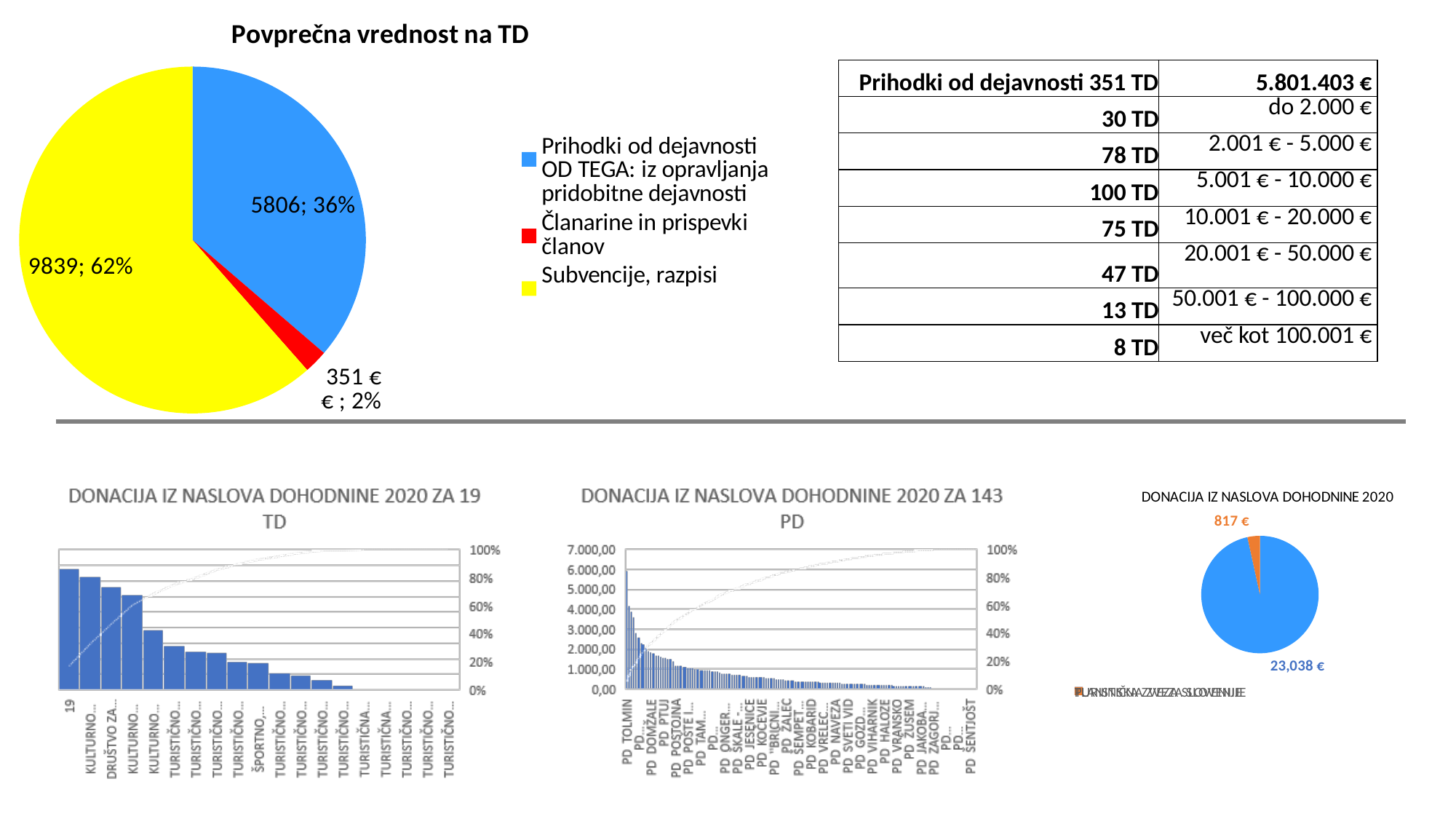
In the pie chart at the bottom right titled 'DONACIJA IZ NASLOVA DOHODNINE 2020', which of the two labelled values is larger, 817 € or 23,038 €? 23,038 € In the pie chart titled 'Povprečna vrednost na TD', what value and share are shown for 'Subvencije, razpisi'? 9839; 62% In the pie chart titled 'Povprečna vrednost na TD', what colour is the slice for 'Subvencije, razpisi'? Yellow In the chart titled 'DONACIJA IZ NASLOVA DOHODNINE 2020 ZA 19 TD', do the bar values rise or fall from left to right? Fall In the pie chart titled 'Povprečna vrednost na TD', which category has the smallest slice? Članarine in prispevki članov In the pie chart at the bottom right titled 'DONACIJA IZ NASLOVA DOHODNINE 2020', what value is shown for the orange slice? 817 € In the pie chart titled 'Povprečna vrednost na TD', what share of the pie does 'Članarine in prispevki članov' have? 2% What kind of chart is the chart titled 'DONACIJA IZ NASLOVA DOHODNINE 2020 ZA 143 PD'? Bar chart In the chart titled 'DONACIJA IZ NASLOVA DOHODNINE 2020 ZA 143 PD', is the value of the first bar (PD TOLMIN) greater or less than 5.000,00? greater In the pie chart titled 'Povprečna vrednost na TD', which category has the largest slice? Subvencije, razpisi How many entries does the legend of the pie chart titled 'Povprečna vrednost na TD' list? 3 In the pie chart titled 'Povprečna vrednost na TD', what value and share are shown for 'Prihodki od dejavnosti'? 5806; 36%